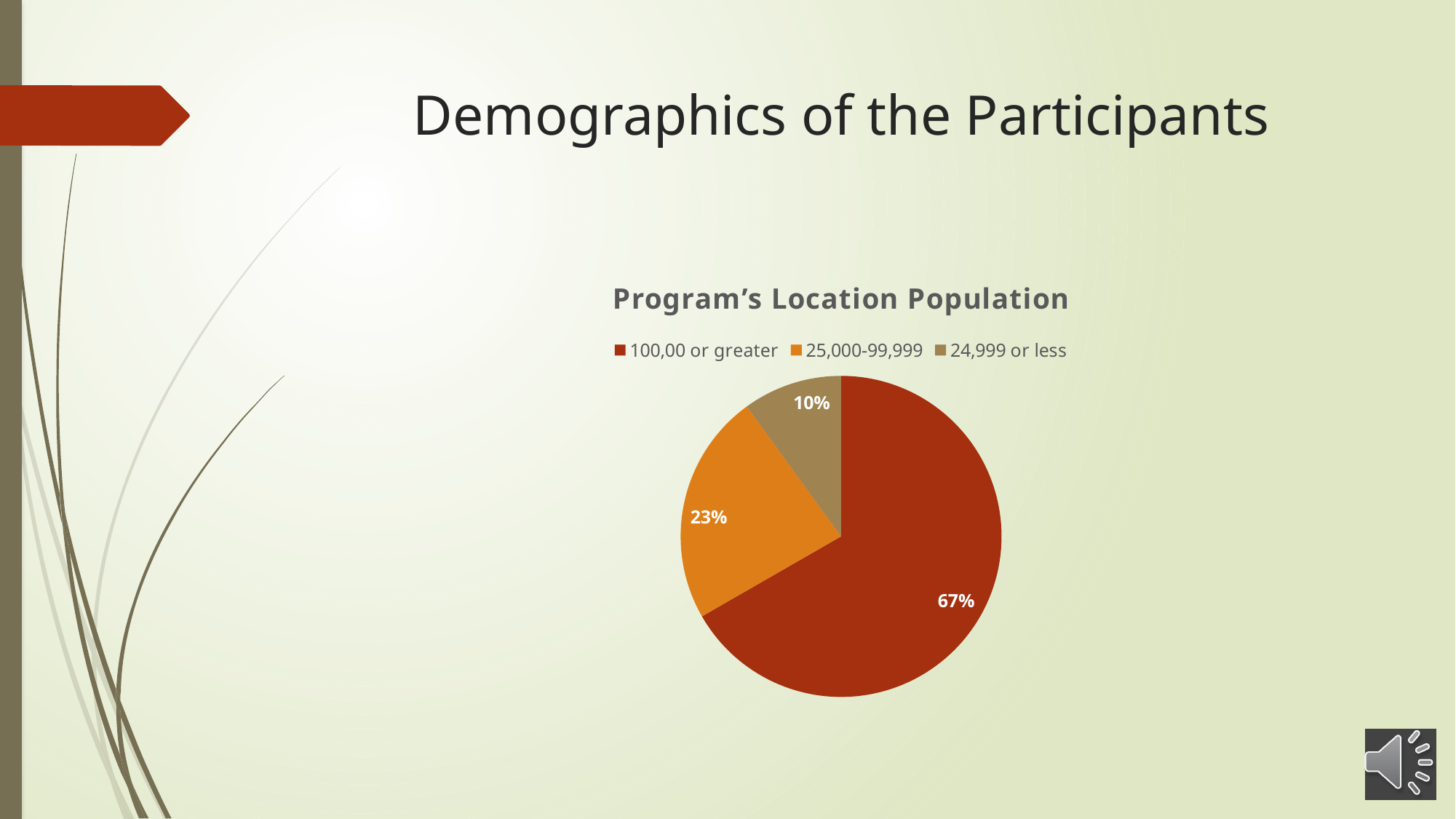
What colour is the slice for "24,999 or less"? Brown/tan Which category has the smallest slice of the pie? 24,999 or less What is the title of the chart? Program's Location Population What is the difference in percentage points between the "25,000-99,999" slice and the "24,999 or less" slice? 13 Which is larger, the "25,000-99,999" slice or the "24,999 or less" slice? 25,000-99,999 What share of the pie is labelled "25,000-99,999"? 23% What share of the pie is labelled "24,999 or less"? 10% What is the difference in percentage points between the "100,00 or greater" slice and the "25,000-99,999" slice? 44 What share of the pie is labelled "100,00 or greater"? 67% Which category has the largest slice of the pie? 100,00 or greater How many categories does the legend list? 3 What kind of chart is shown on the slide? Pie chart